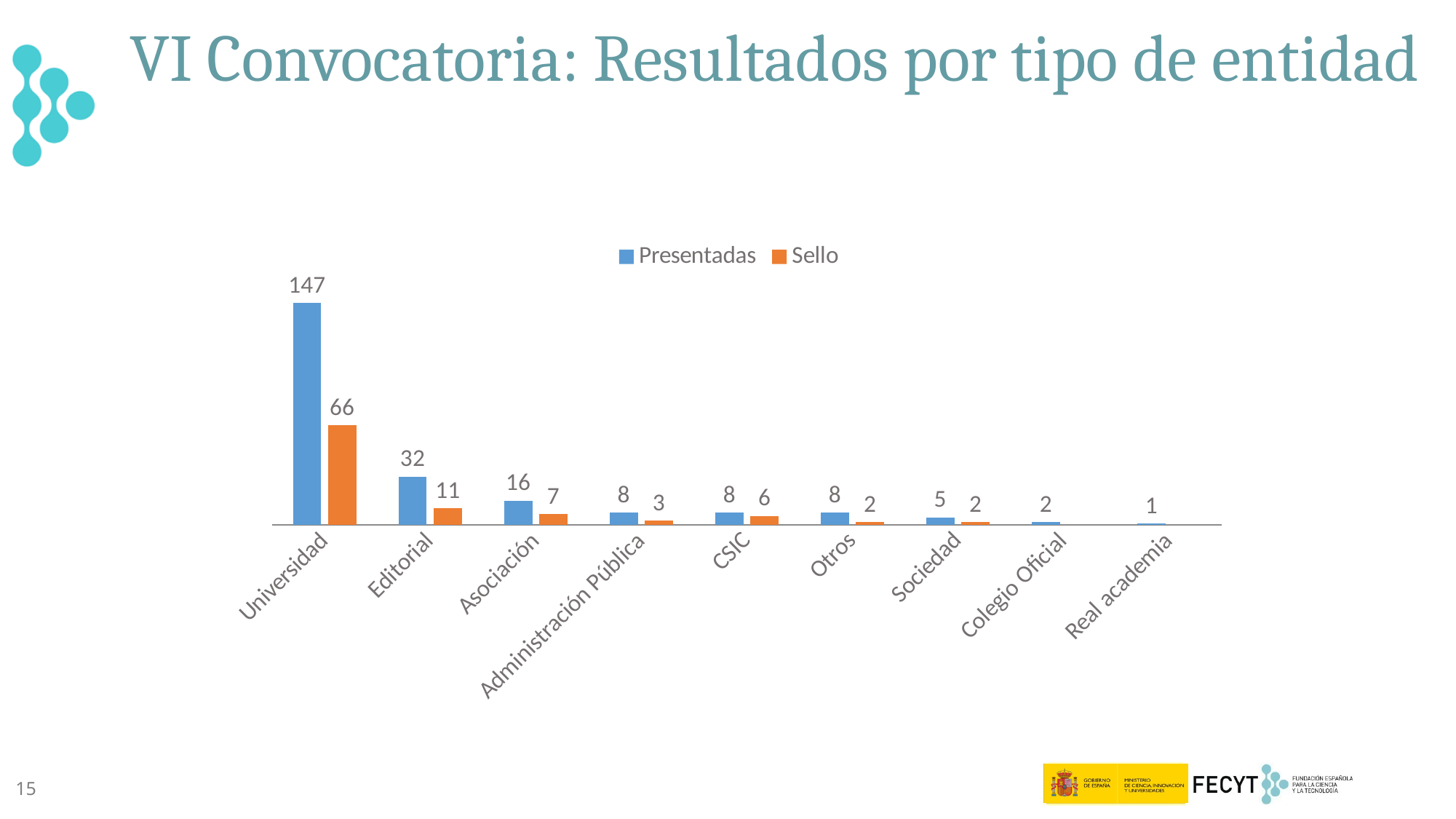
Which colour represents the Sello series? Orange Which category has the lowest Presentadas value? Real academia What kind of chart is shown on the slide? Bar chart What is the Sello value for CSIC? 6 Which is larger, the Sello value for Asociación or the Sello value for CSIC? Asociación How many series does the legend list? 2 Which category has the highest Presentadas value? Universidad What is the difference between Presentadas and Sello for Universidad? 81 What is the difference between the Presentadas values for Editorial and Asociación? 16 What is the Presentadas value for Universidad? 147 How many categories are shown on the x axis? 9 What is the Sello value for Editorial? 11